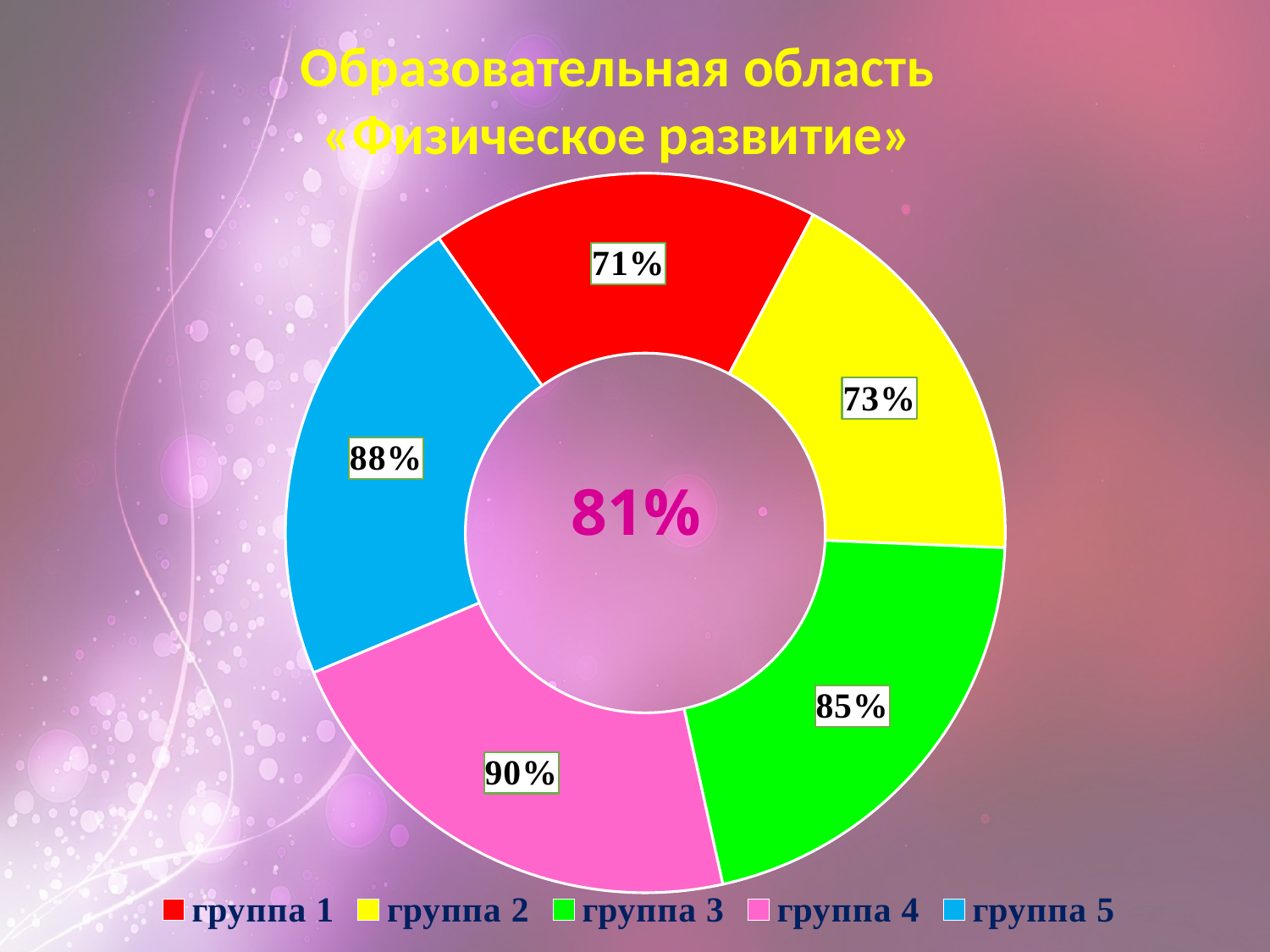
What value is shown for группа 1? 71% What value is shown for группа 3? 85% What value is shown for группа 2? 73% What value is printed in the centre of the chart? 81% What is the difference between the values for группа 4 and группа 1? 19% Which group has the highest value? группа 4 How many groups are shown in the chart? 5 What value is shown for группа 5? 88% What value is shown for группа 4? 90% What kind of chart is shown on the slide? doughnut chart Which group has the lowest value? группа 1 Which is larger, the value for группа 3 or the value for группа 5? группа 5